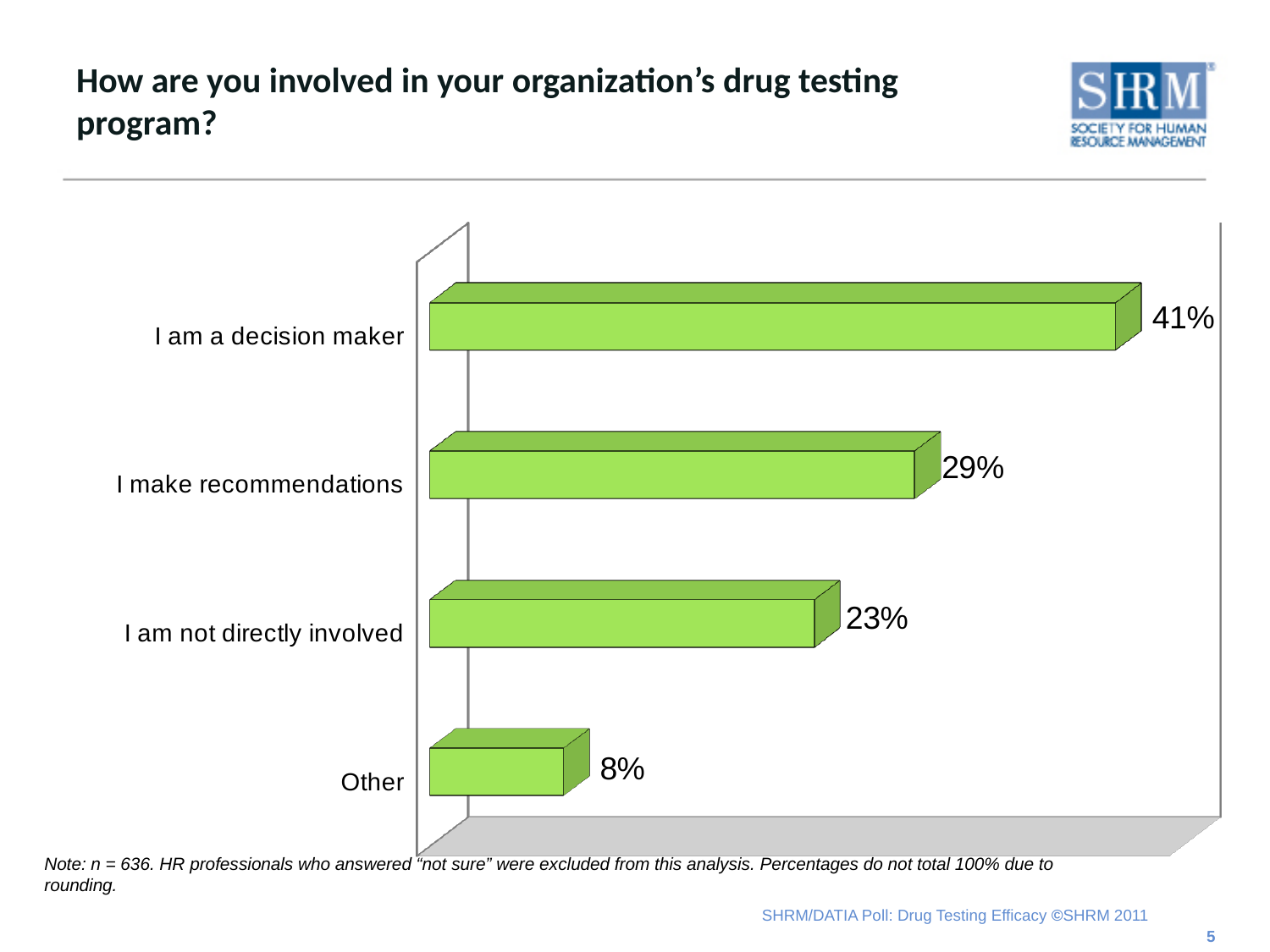
What kind of chart is shown on the slide? Bar chart Which is larger, "I make recommendations" or "I am not directly involved"? I make recommendations Which category has the highest value? I am a decision maker What is the sample size (n) given in the note below the chart? 636 What is the difference between "I am a decision maker" and "I make recommendations"? 12% What is the value for "I am not directly involved"? 23% Which category has the lowest value? Other What is the value for "I make recommendations"? 29% What is the value for "Other"? 8% What is the difference between "I am not directly involved" and "Other"? 15% How many categories are shown in the chart? 4 What percentage of respondents said "I am a decision maker"? 41%